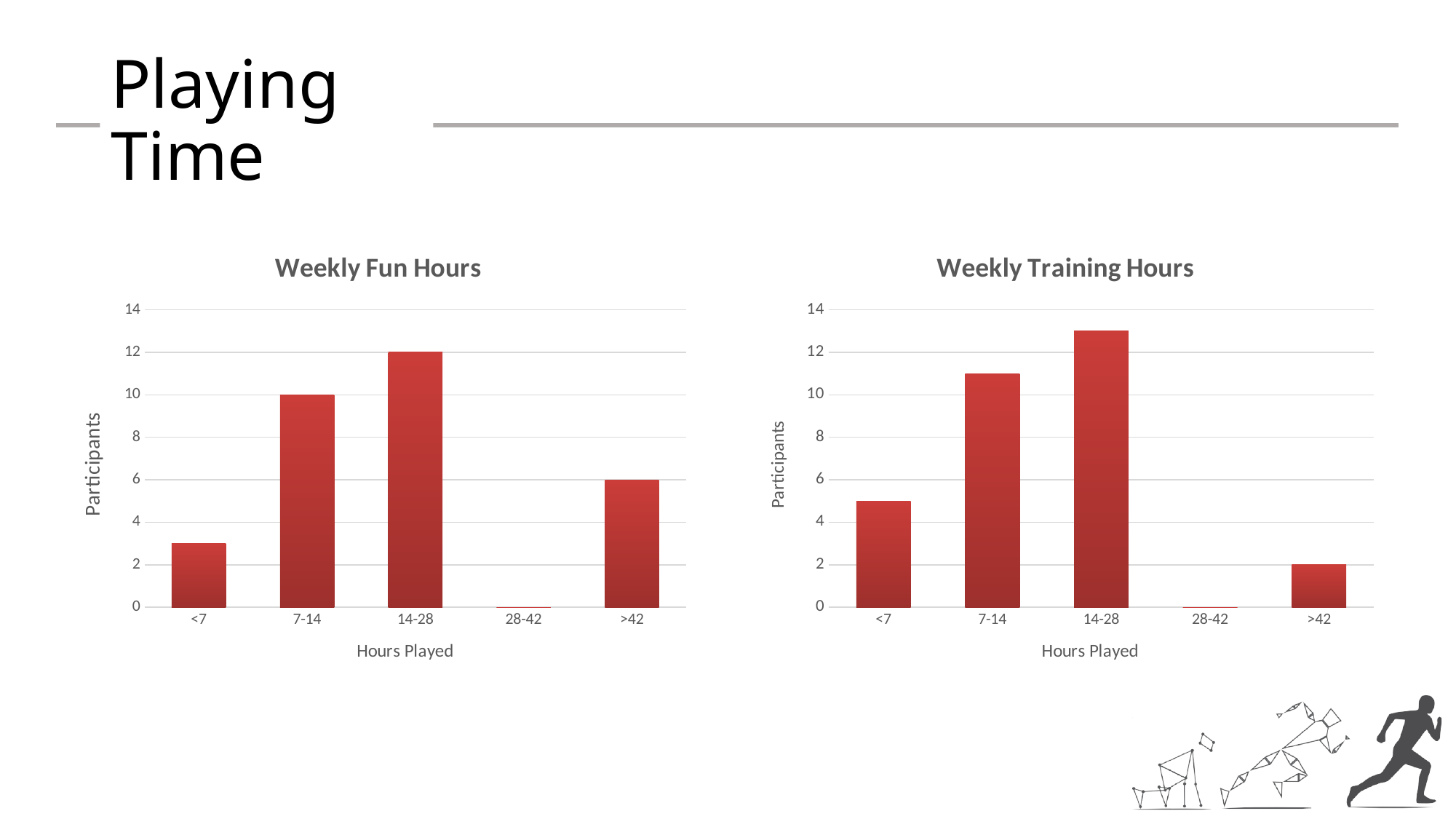
In the Weekly Training Hours chart, which has more participants, the <7 category or the 7-14 category? 7-14 In the Weekly Fun Hours chart, how many participants are in the 7-14 hours category? 10 In the Weekly Training Hours chart, how many participants are in the >42 hours category? 2 In the Weekly Fun Hours chart, what is the difference in participants between the 14-28 and 7-14 categories? 2 In the Weekly Training Hours chart, is the value for the 14-28 category greater or less than 12? greater In the Weekly Training Hours chart, which hours category has the fewest participants? 28-42 In the Weekly Fun Hours chart, how many participants are in the 14-28 hours category? 12 In the Weekly Training Hours chart, which hours category has the most participants? 14-28 In the Weekly Fun Hours chart, which hours category has the most participants? 14-28 In the Weekly Training Hours chart, is the value for the <7 category greater or less than 4? greater How many hours categories are shown on the x axis of the Weekly Fun Hours chart? 5 In the Weekly Fun Hours chart, how many participants are in the >42 hours category? 6